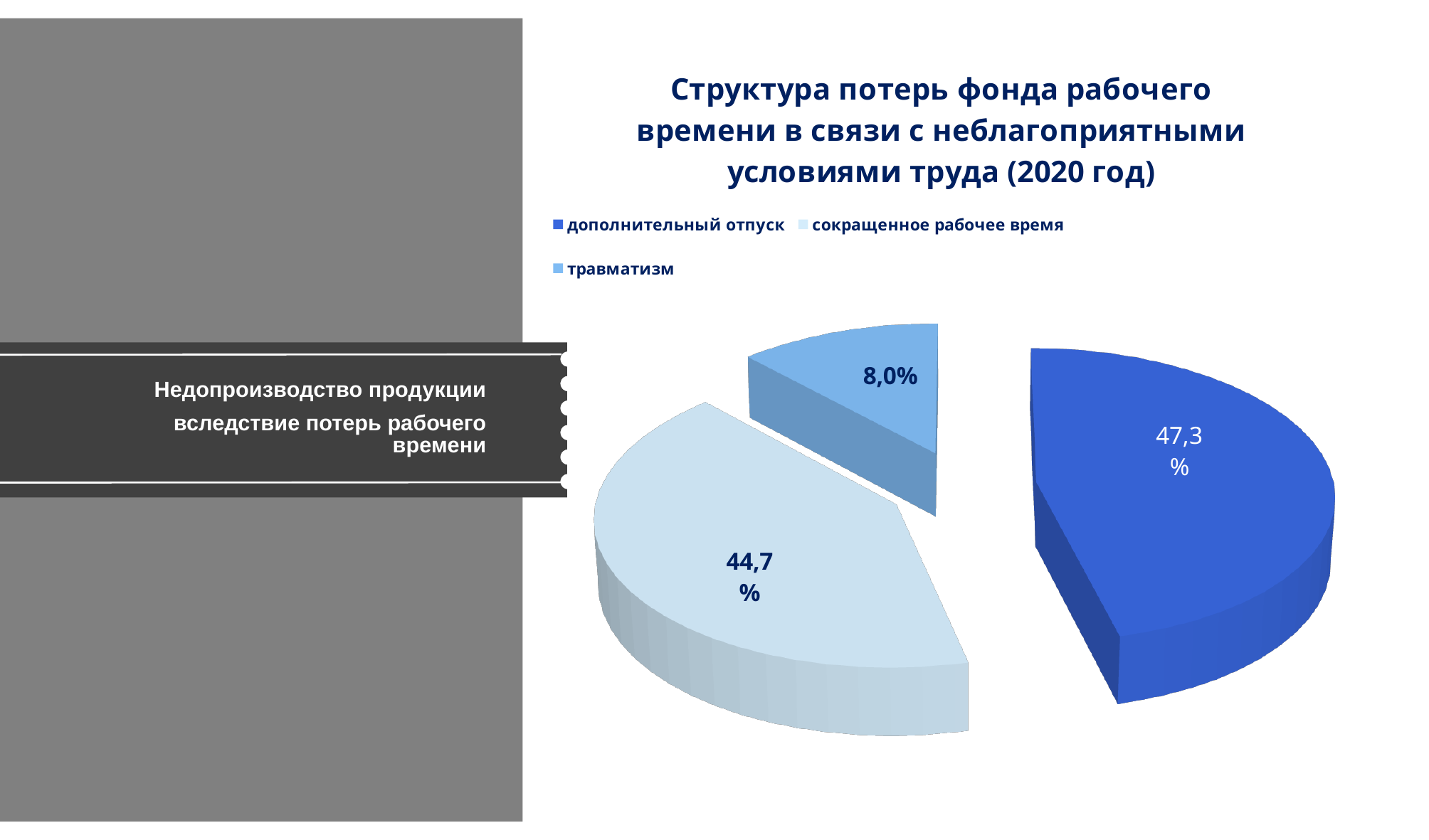
What is the difference between the shares of "дополнительный отпуск" and "сокращенное рабочее время"? 2,6% How many entries does the legend list? 3 What share of the pie does "дополнительный отпуск" account for? 47,3% How many slices does the pie chart have? 3 What share of the pie does "сокращенное рабочее время" account for? 44,7% What is the title of the chart? Структура потерь фонда рабочего времени в связи с неблагоприятными условиями труда (2020 год) Which is larger: the share of "сокращенное рабочее время" or the share of "травматизм"? сокращенное рабочее время What kind of chart is shown on the slide? pie chart What is the difference between the shares of "сокращенное рабочее время" and "травматизм"? 36,7% What share of the pie does "травматизм" account for? 8,0% Which category has the smallest slice of the pie? травматизм Which category has the largest slice of the pie? дополнительный отпуск